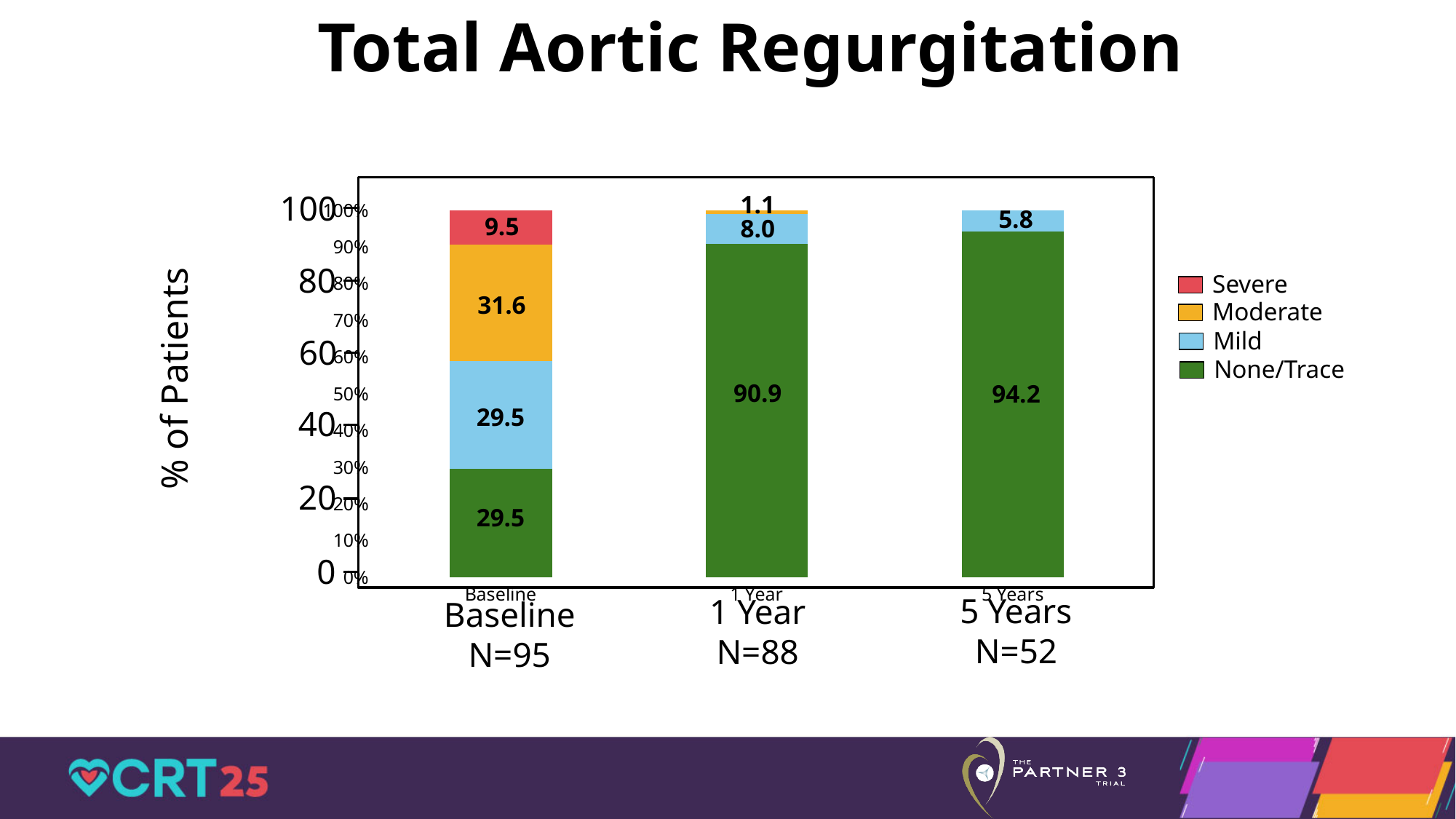
What is the Severe value at Baseline? 9.5 At which time point is the Mild value lowest? 5 Years What is the None/Trace value at 5 Years? 94.2 What kind of chart is shown on the slide? Stacked bar chart What is the difference between the None/Trace value at 5 Years and at 1 Year? 3.3 What is the None/Trace value at Baseline? 29.5 How many series does the legend list? 4 Which is larger at Baseline, the Moderate value or the Mild value? Moderate What is the Mild value at 1 Year? 8.0 At which time point is the None/Trace value highest? 5 Years Does the None/Trace value rise or fall from Baseline to 5 Years? Rise What is the Moderate value at Baseline? 31.6